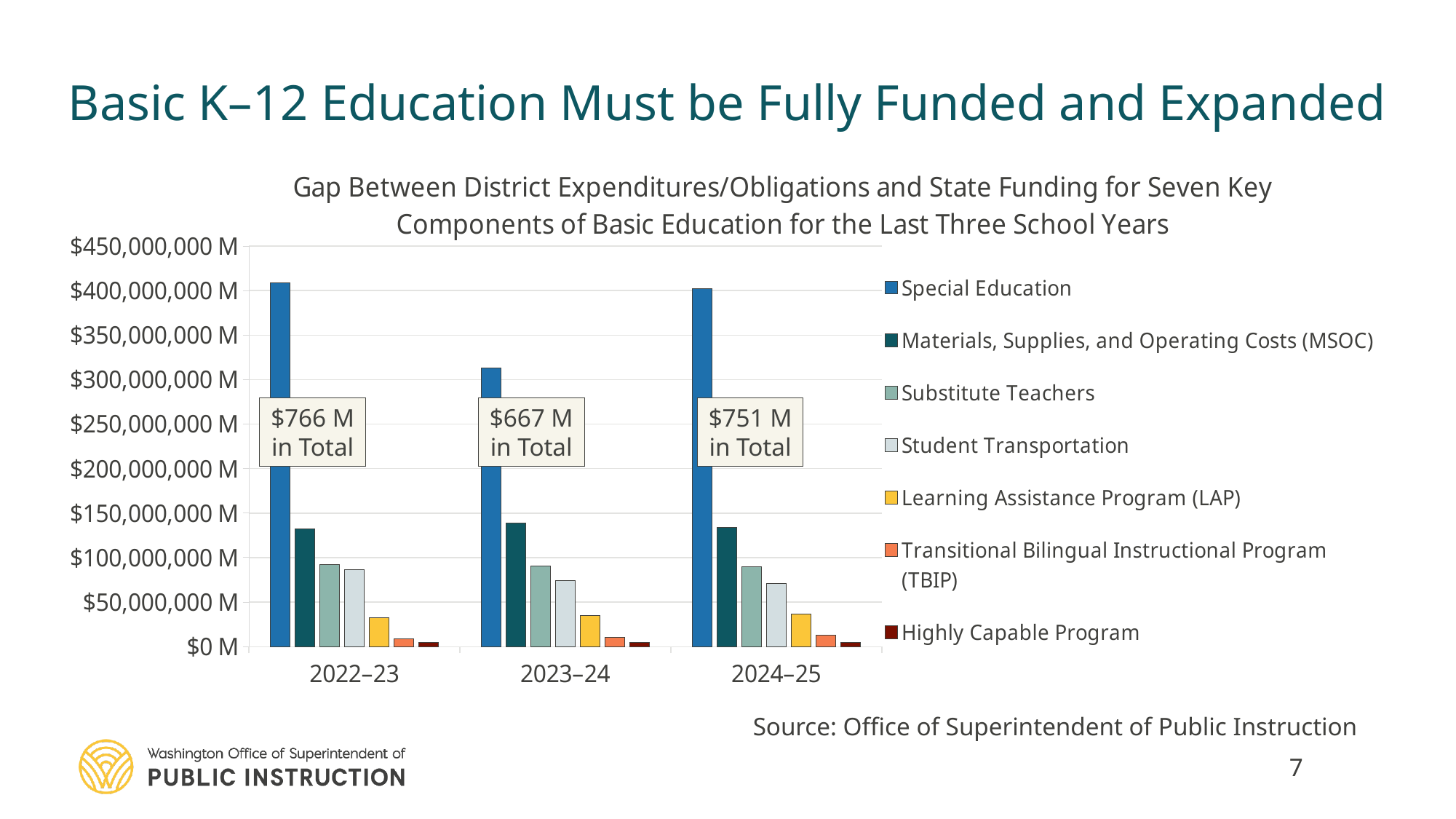
Is the value for Special Education in 2023–24 greater or less than $350,000,000 M? less How many series does the legend list? 7 In 2024–25, which is larger: Special Education or Materials, Supplies, and Operating Costs (MSOC)? Special Education What is the total gap shown for 2024–25? $751 M Which school year has the highest total gap? 2022–23 What is the difference between the total gap for 2022–23 and the total gap for 2023–24? $99 M Which series has the smallest bar in every school year? Highly Capable Program What is the total gap shown for 2022–23? $766 M How many school years are shown on the x axis? 3 What is the total gap shown for 2023–24? $667 M What kind of chart is shown on the slide? bar chart Which school year has the lowest total gap? 2023–24